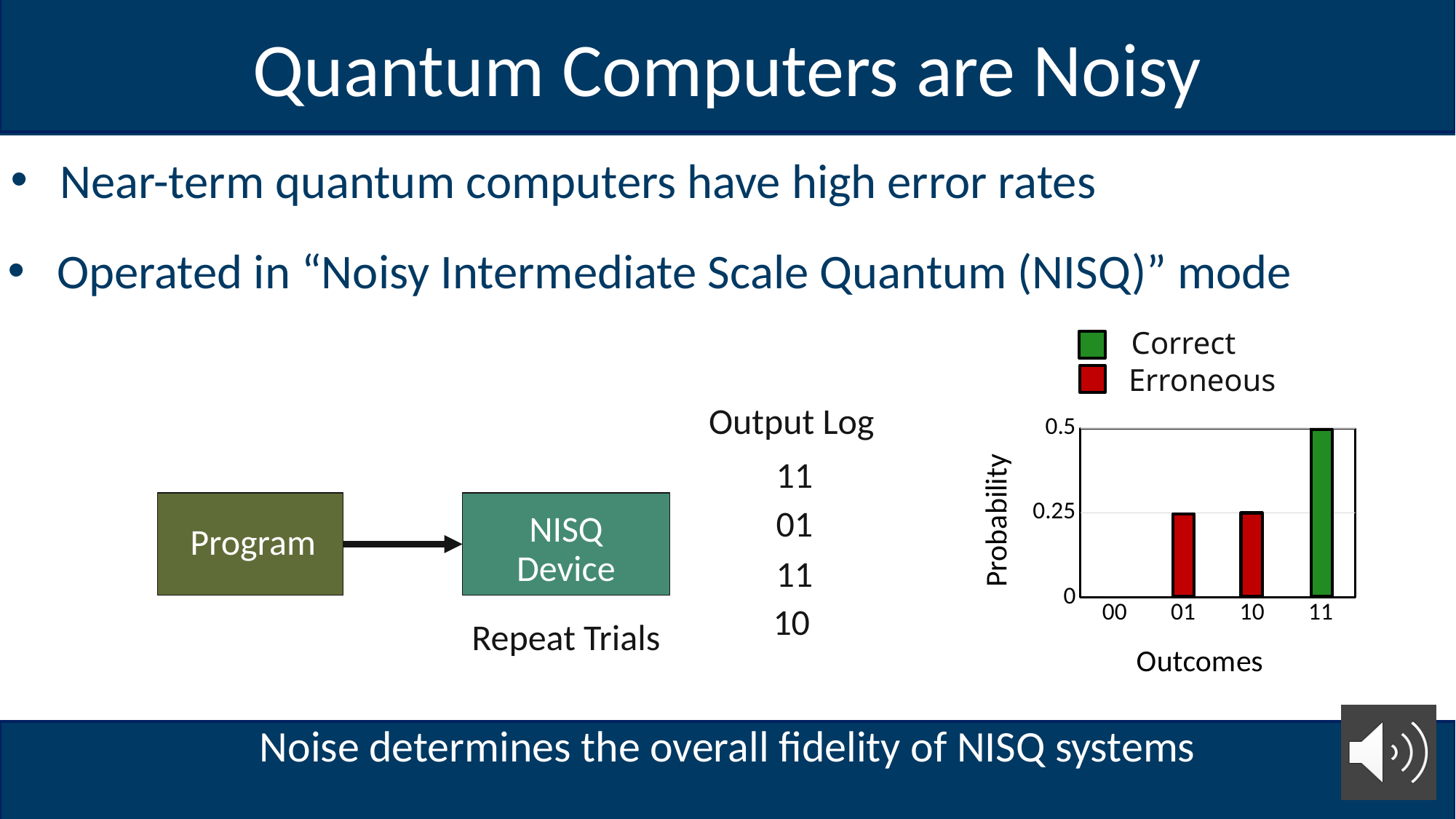
What colour are the bars labelled Erroneous in the chart's legend? red What kind of chart is shown on the slide? bar chart How many entries does the chart's legend list? 2 Which outcome has the highest probability in the chart? 11 What is the difference between the probability for outcome 11 and the probability for outcome 10? 0.25 Which outcome has the lowest probability in the chart? 00 How many outcome categories are shown on the x axis of the chart? 4 What is the label of the y axis of the chart? Probability Is the probability for outcome 11 larger than the probability for outcome 01? yes What is the probability for outcome 01? 0.25 What is the probability for outcome 10? 0.25 What is the probability for outcome 11? 0.5